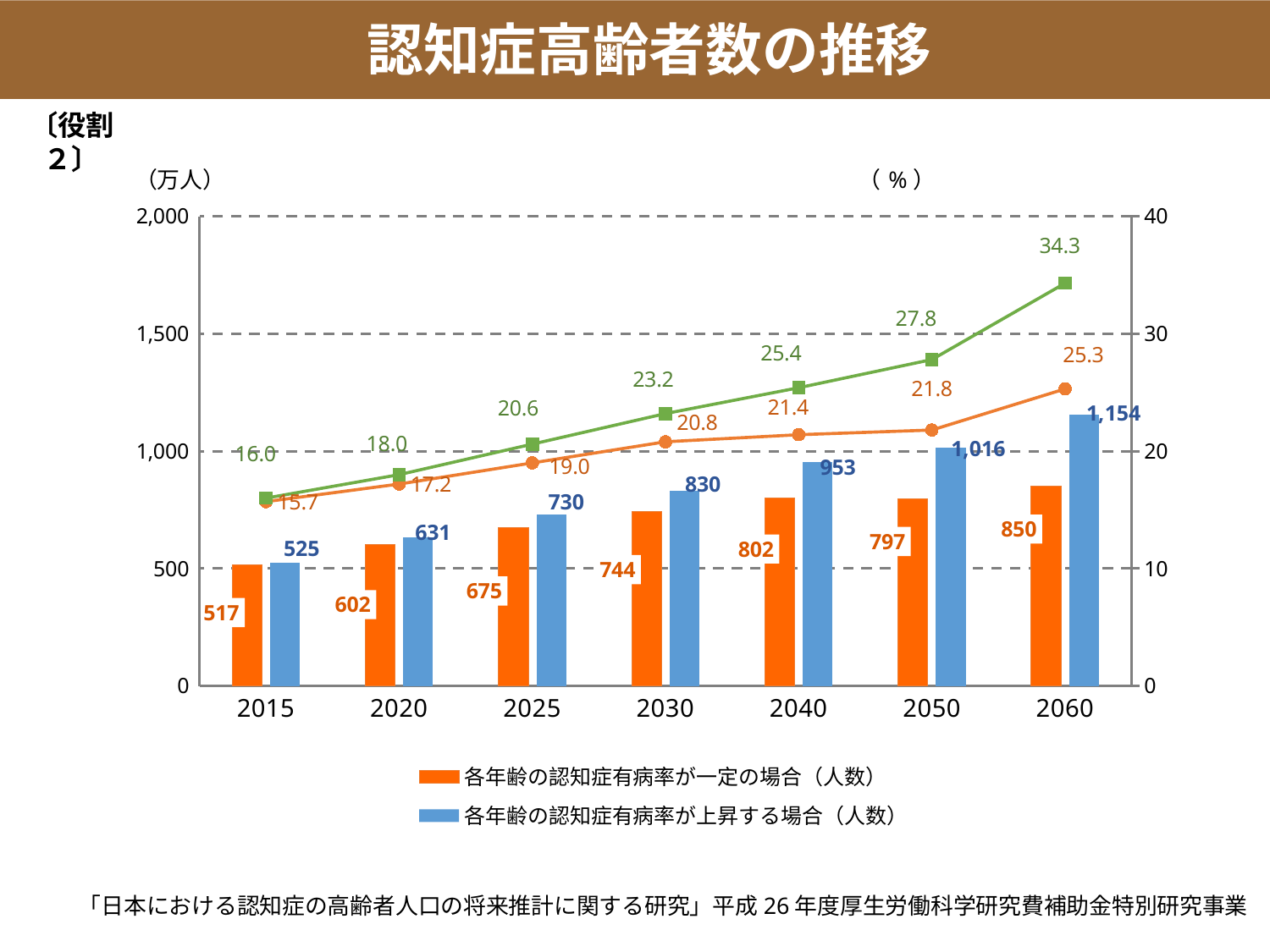
What is the value of the orange bar (各年齢の認知症有病率が一定の場合) for 2015? 517 Does the green line rise or fall from 2015 to 2060? rise How many series does the legend list? 2 What is the value of the green line's data label for 2040? 25.4 How many years are shown on the x axis? 7 Which is larger in 2040: the orange bar (各年齢の認知症有病率が一定の場合) or the blue bar (各年齢の認知症有病率が上昇する場合)? the blue bar (各年齢の認知症有病率が上昇する場合) In which year is the orange bar (各年齢の認知症有病率が一定の場合) lowest? 2015 What is the value of the orange line's data label for 2025? 19.0 What is the title of the slide's chart? 認知症高齢者数の推移 In which year is the blue bar (各年齢の認知症有病率が上昇する場合) highest? 2060 What is the value of the blue bar (各年齢の認知症有病率が上昇する場合) for 2060? 1,154 What is the difference between the blue bar and the orange bar in 2050? 219